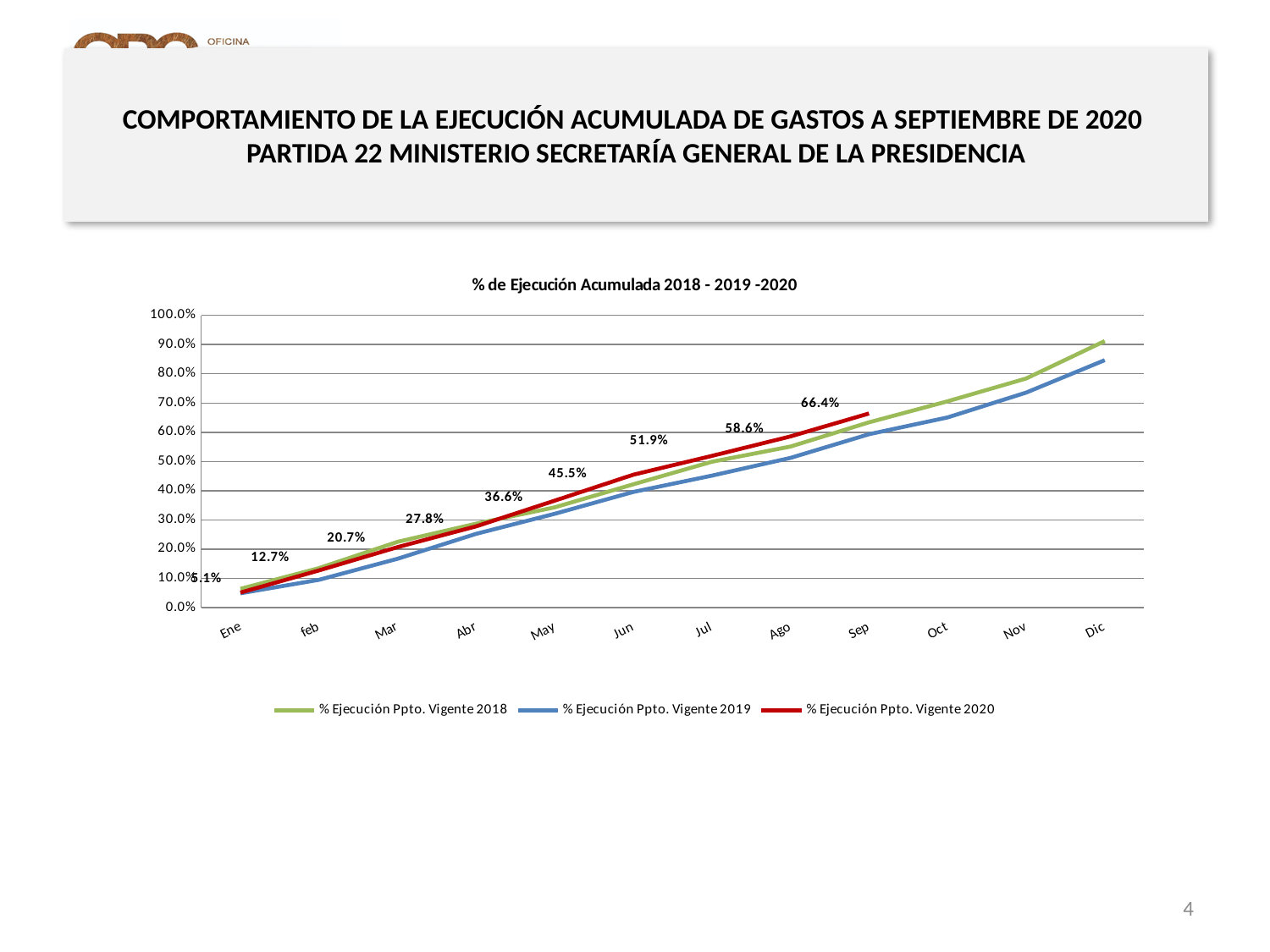
Is the value of % Ejecución Ppto. Vigente 2018 in Dic greater or less than 80.0%? greater What is the value of % Ejecución Ppto. Vigente 2020 in May? 36.6% How many series does the legend list? 3 What type of chart is shown on the slide? line chart What is the value of % Ejecución Ppto. Vigente 2020 in Ene? 5.1% What is the value of % Ejecución Ppto. Vigente 2020 in Sep? 66.4% What is the value of % Ejecución Ppto. Vigente 2020 in Jul? 51.9% What is the difference between the 2020 values for Sep and Ago? 7.8% Does the % Ejecución Ppto. Vigente 2020 line rise or fall from Ene to Sep? rise What is the difference between the 2020 values for Jun and Ene? 40.4% How many months are shown on the x axis? 12 What is the title of the chart? % de Ejecución Acumulada 2018 - 2019 -2020